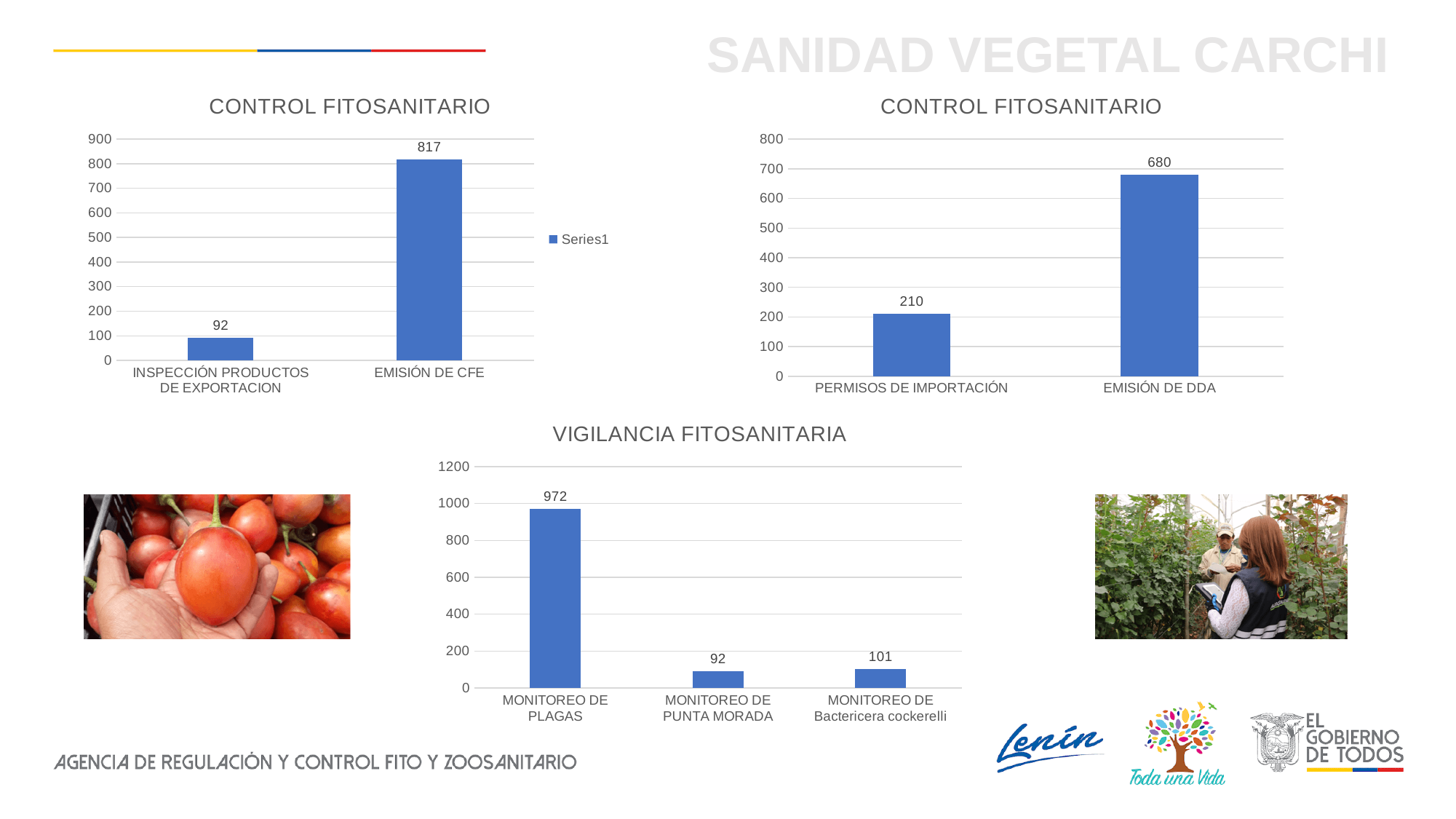
In the VIGILANCIA FITOSANITARIA chart, how many categories are shown? 3 In the top-right CONTROL FITOSANITARIO chart, which category has the highest value? EMISIÓN DE DDA In the VIGILANCIA FITOSANITARIA chart, what is the value for MONITOREO DE PLAGAS? 972 In the VIGILANCIA FITOSANITARIA chart, which is larger: MONITOREO DE Bactericera cockerelli or MONITOREO DE PUNTA MORADA? MONITOREO DE Bactericera cockerelli In the top-right CONTROL FITOSANITARIO chart, what is the value for PERMISOS DE IMPORTACIÓN? 210 What kind of chart is the VIGILANCIA FITOSANITARIA chart? Bar chart In the top-left CONTROL FITOSANITARIO chart, what series name does the legend show? Series1 In the VIGILANCIA FITOSANITARIA chart, which category has the lowest value? MONITOREO DE PUNTA MORADA In the top-left CONTROL FITOSANITARIO chart, what is the difference between EMISIÓN DE CFE and INSPECCIÓN PRODUCTOS DE EXPORTACION? 725 In the top-left CONTROL FITOSANITARIO chart, what is the value for EMISIÓN DE CFE? 817 In the top-left CONTROL FITOSANITARIO chart, what is the value for INSPECCIÓN PRODUCTOS DE EXPORTACION? 92 In the top-right CONTROL FITOSANITARIO chart, what is the difference between EMISIÓN DE DDA and PERMISOS DE IMPORTACIÓN? 470